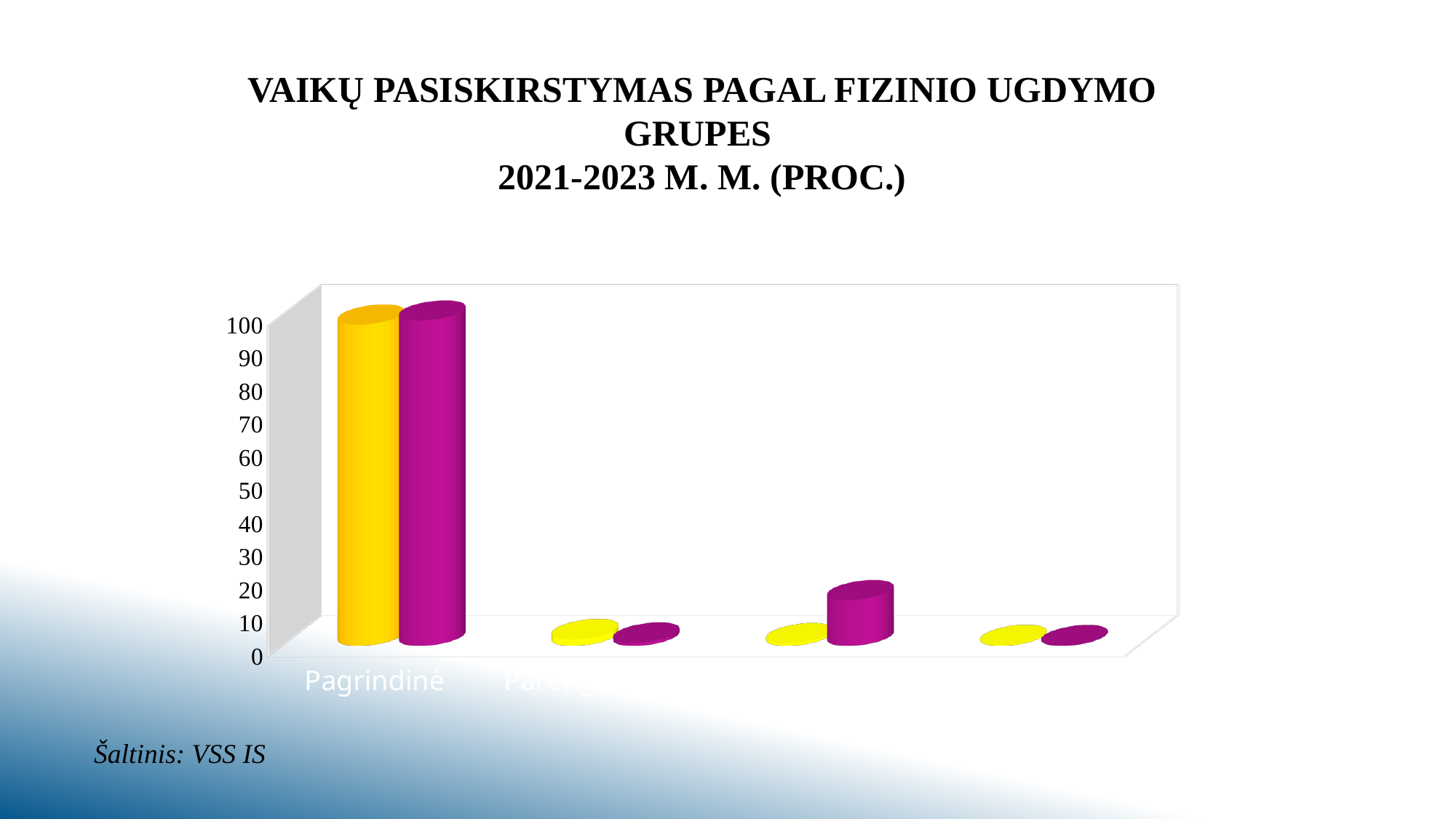
Is the value of the yellow bar in the fourth category greater or less than 20? less Is the value of the magenta bar in the third category greater or less than 50? less Which category has the highest values in the chart? Pagrindinė In the third category, which bar is taller, the yellow one or the magenta one? the magenta one What kind of chart is shown on the slide? bar chart How many data series (bar colours) are plotted in the chart? 2 What source is cited below the chart? VSS IS Is the value of the magenta bar for Pagrindinė greater or less than 80? greater What is the highest value shown on the vertical axis of the chart? 100 How many categories (groups of bars) are plotted in the chart? 4